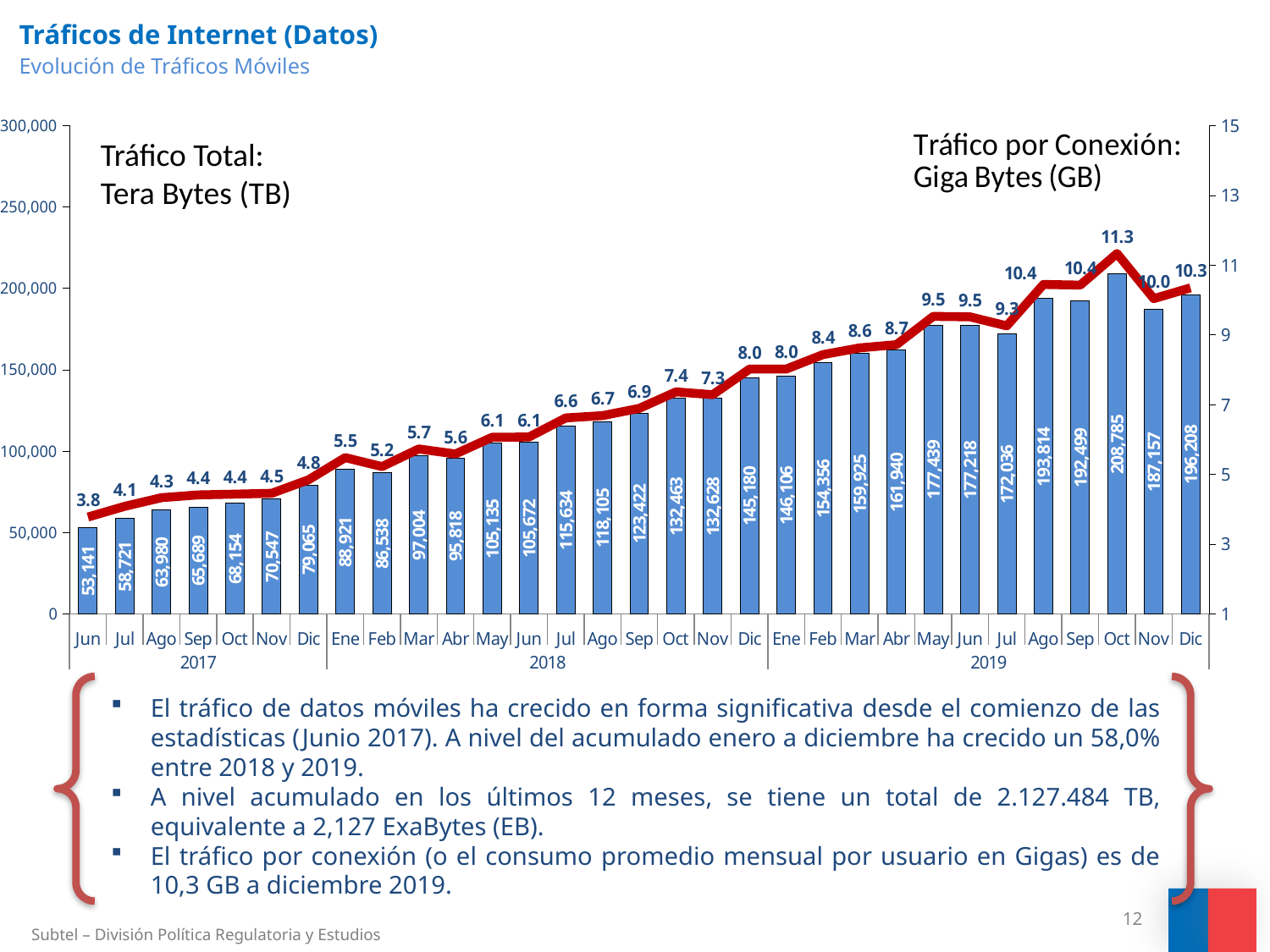
Which month has the highest total traffic bar? Oct 2019 What unit is used for the right-hand axis (Tráfico por Conexión)? Giga Bytes (GB) How many monthly bars are plotted in the chart? 31 Which month has the lowest total traffic bar? Jun 2017 What kind of chart is shown on the slide? Combined bar and line chart What is the total mobile traffic (TB) shown for Oct 2019? 208,785 Which is larger, the total traffic bar for Ene 2018 or for Feb 2018? Ene 2018 What is the total traffic value (TB) for Jun 2017, the first month shown? 53,141 What is the difference in total traffic (TB) between Dic 2019 and Nov 2019? 9,051 What is the traffic per connection (GB) shown for Dic 2019? 10.3 What is the highest traffic per connection value shown on the line? 11.3 Do the total traffic bars generally rise or fall from Jun 2017 to Dic 2019? Rise